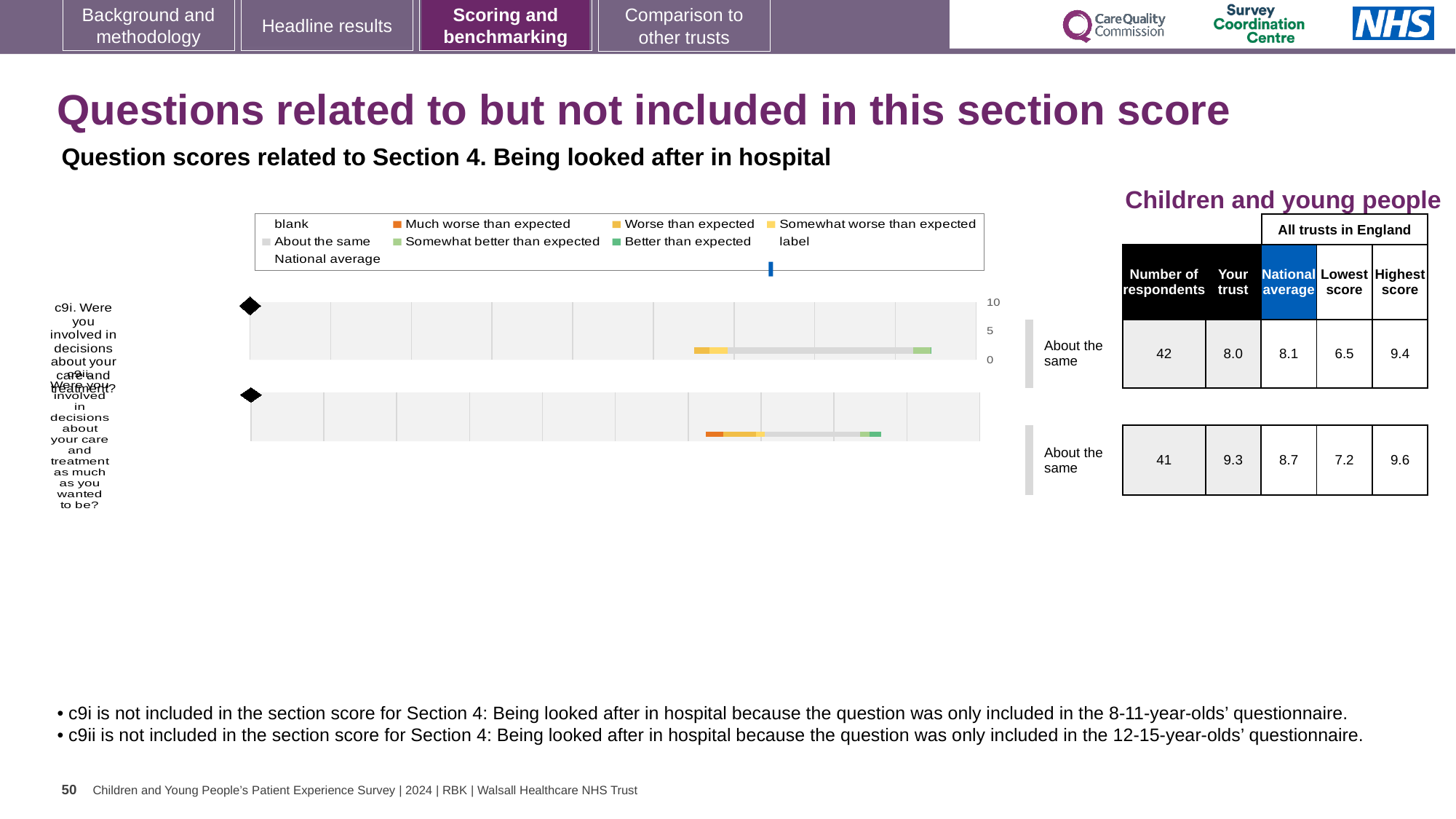
According to the table next to the charts, what is the 'Your trust' score for question c9i? 8.0 According to the table, what is the national average for question c9ii? 8.7 Which legend entry is shown in orange in the chart legend? Much worse than expected What benchmark category is shown beside the bar for question c9ii? About the same According to the table, what is the number of respondents for question c9i? 42 What is the highest value shown on the vertical axis of the c9i chart? 10 How many entries does the chart legend list? 9 What kind of chart is used to show the benchmark bands for questions c9i and c9ii? bar chart According to the table, what is the difference between the highest score and the lowest score for question c9i? 2.9 How many questions (c9i and c9ii) are plotted as bars on the slide? 2 According to the table next to the charts, what is the 'Your trust' score for question c9ii? 9.3 According to the table, which question has the higher 'Your trust' score, c9i or c9ii? c9ii